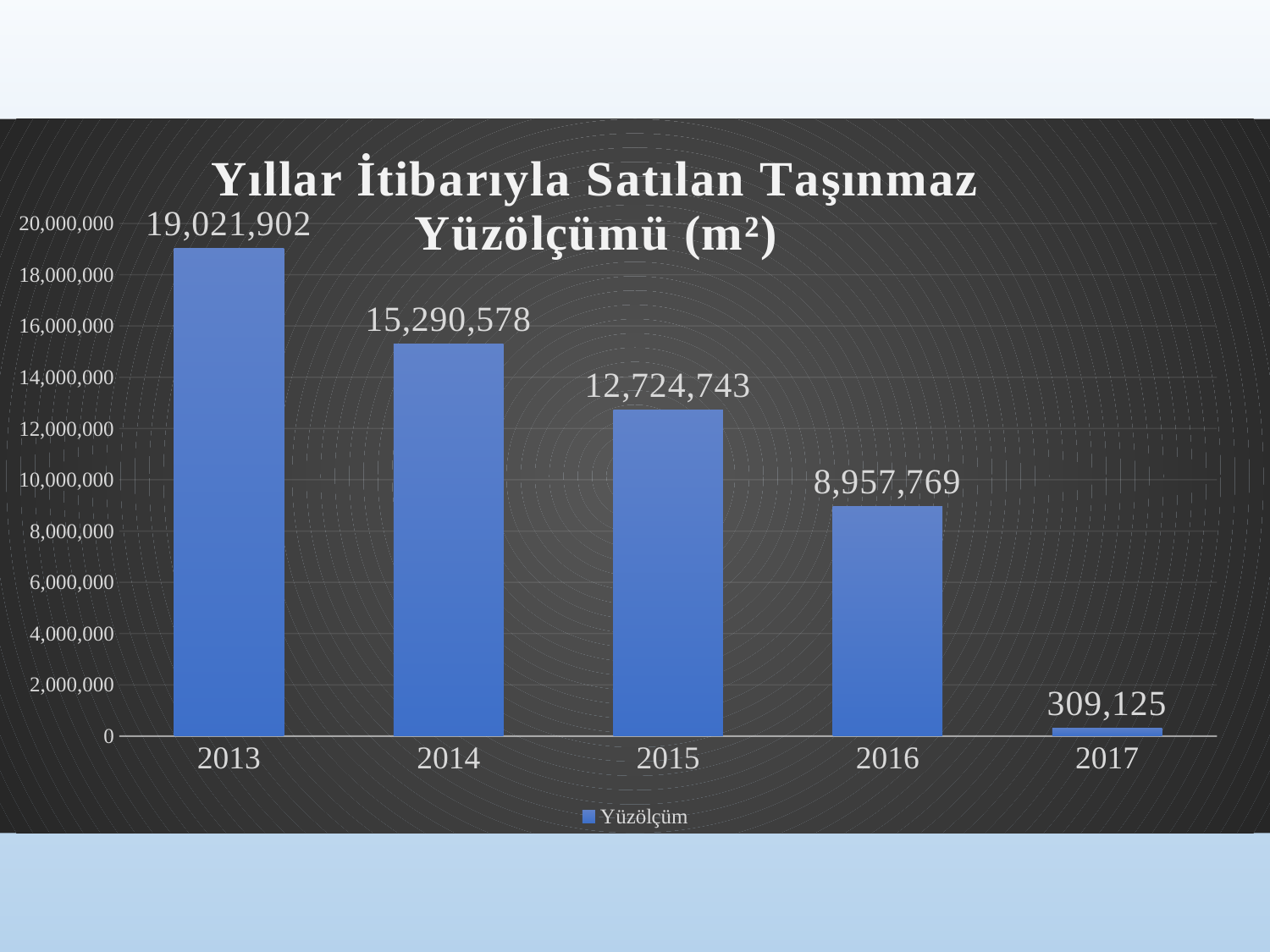
Is the value for 2016 greater or less than 10,000,000? less How many years are shown on the x axis? 5 Which is larger, the value for 2014 or the value for 2016? 2014 What is the difference between the values for 2015 and 2016? 3,766,974 Which year has the lowest value? 2017 What is the value for 2017? 309,125 What is the value for 2015? 12,724,743 What is the difference between the values for 2013 and 2014? 3,731,324 Do the values rise or fall from 2013 to 2017? fall What kind of chart is this? bar chart What is the value for 2013? 19,021,902 Which year has the highest value? 2013